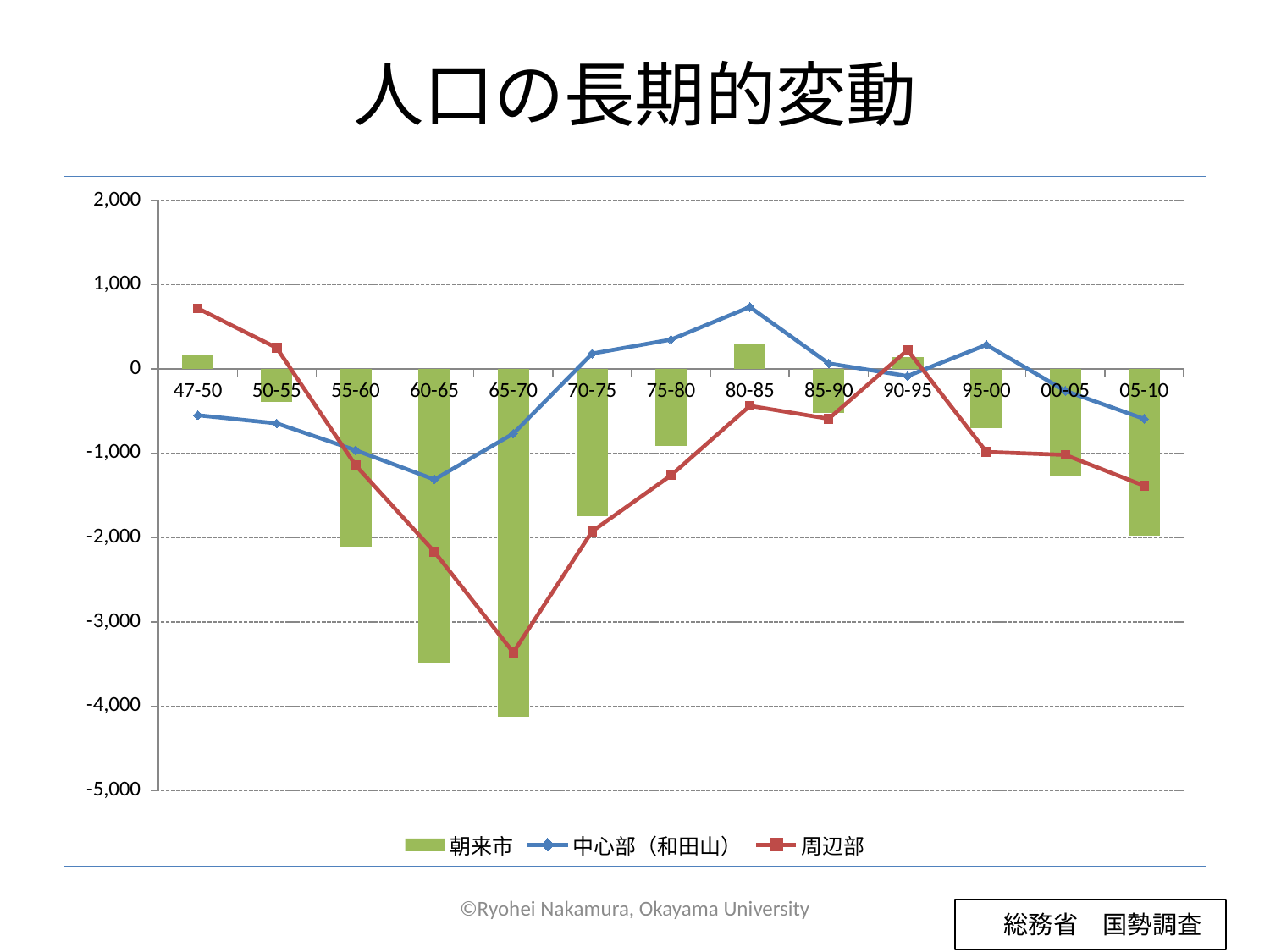
Does the 周辺部 line rise or fall from 47-50 to 65-70? fall How many period categories are shown on the x axis? 13 Is the 中心部（和田山） value for 60-65 greater or less than -1,000? less Is the 朝来市 value for 60-65 greater or less than -3,000? less In which period does the 中心部（和田山） line reach its highest value? 80-85 Is the 周辺部 value for 47-50 greater or less than 0? greater How many series does the legend list? 3 In which period is the 朝来市 bar lowest? 65-70 For the period 70-75, which is larger: 中心部（和田山） or 周辺部? 中心部（和田山） In which period is the 朝来市 bar highest? 80-85 In which period does the 周辺部 line reach its lowest value? 65-70 What kind of chart is shown on the slide? A combination bar and line chart